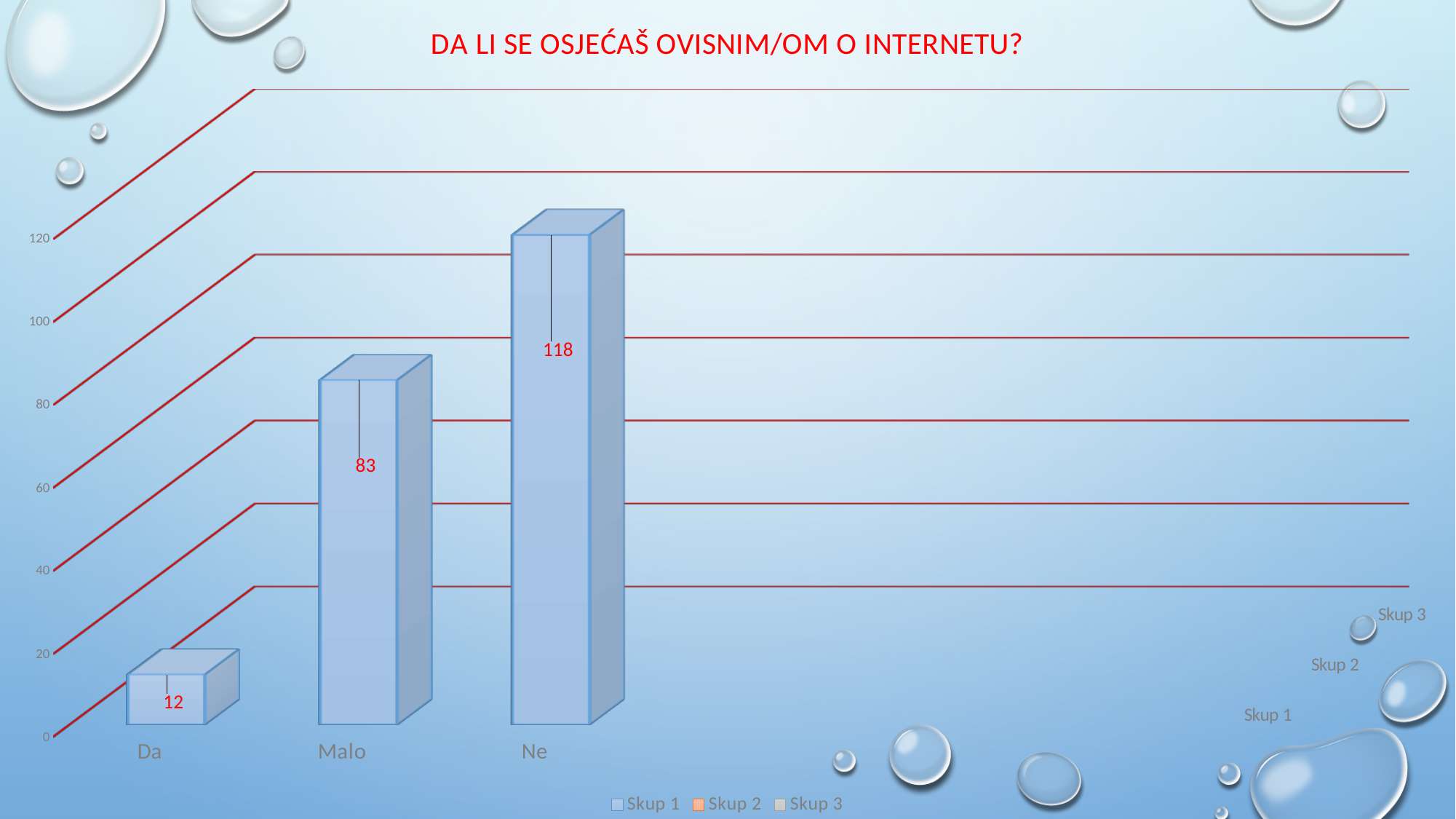
Which is larger, the value for "Malo" or the value for "Da"? Malo What is the value for "Da"? 12 What is the value for "Ne"? 118 Which category has the lowest value? Da What is the title of the chart? DA LI SE OSJEĆAŠ OVISNIM/OM O INTERNETU? What is the difference between the values for "Ne" and "Malo"? 35 How many categories are shown on the x axis? 3 How many series does the legend list? 3 Which category has the highest value? Ne What is the difference between the values for "Malo" and "Da"? 71 What is the value for "Malo"? 83 What kind of chart is shown on the slide? bar chart